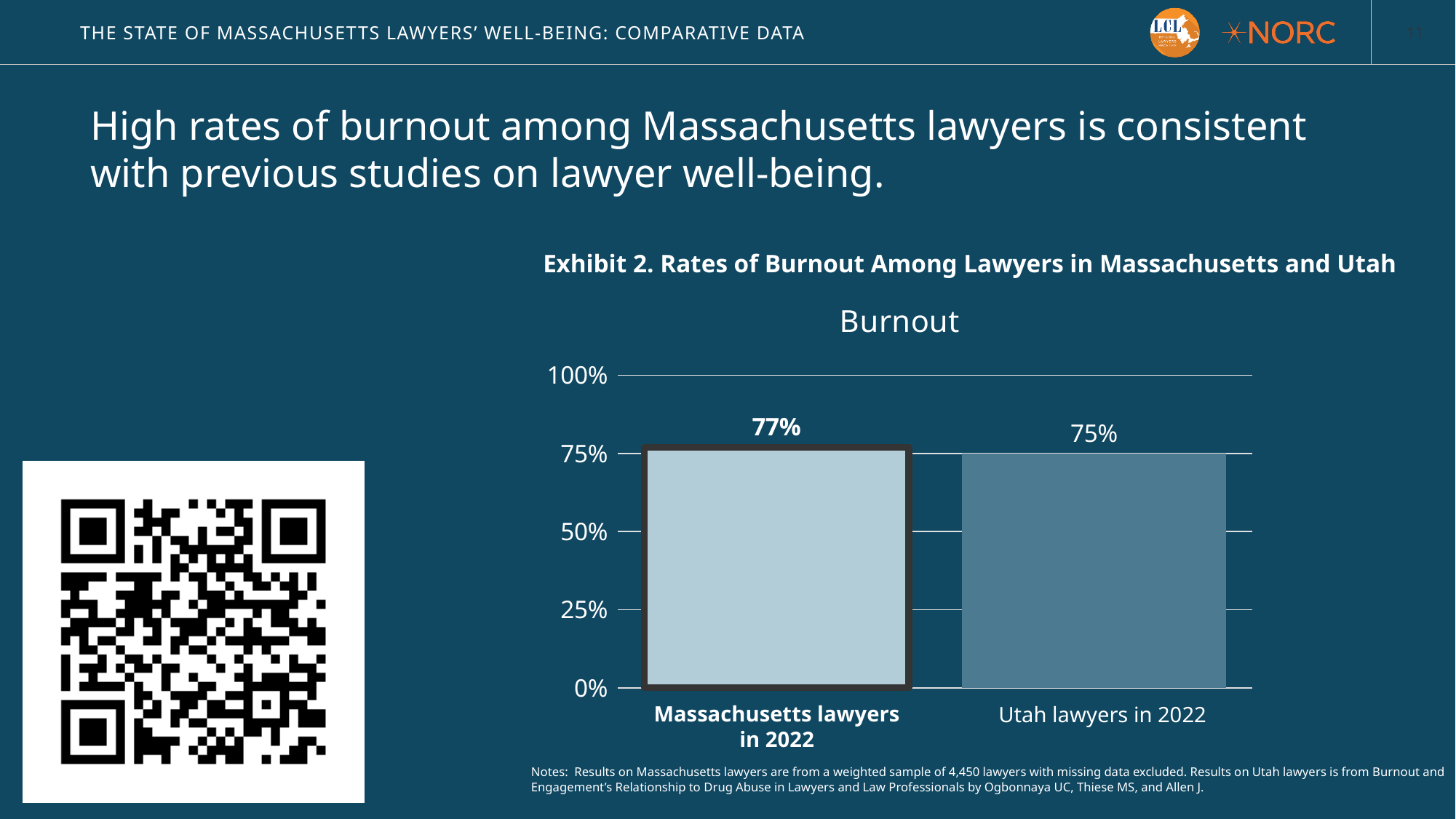
Which group has the higher burnout rate? Massachusetts lawyers in 2022 What is the highest value shown on the y axis of the chart? 100% How many categories are shown in the chart? 2 What is the burnout rate for Massachusetts lawyers in 2022? 77% What kind of chart is shown on the slide? Bar chart Which group has the lower burnout rate? Utah lawyers in 2022 What is the title of the exhibit on the slide? Exhibit 2. Rates of Burnout Among Lawyers in Massachusetts and Utah What is the burnout rate for Utah lawyers in 2022? 75% Is the burnout rate for Utah lawyers in 2022 greater or less than 50%? greater Is the burnout rate for Massachusetts lawyers in 2022 greater or less than 100%? less What is the difference in burnout rate between Massachusetts lawyers in 2022 and Utah lawyers in 2022? 2%